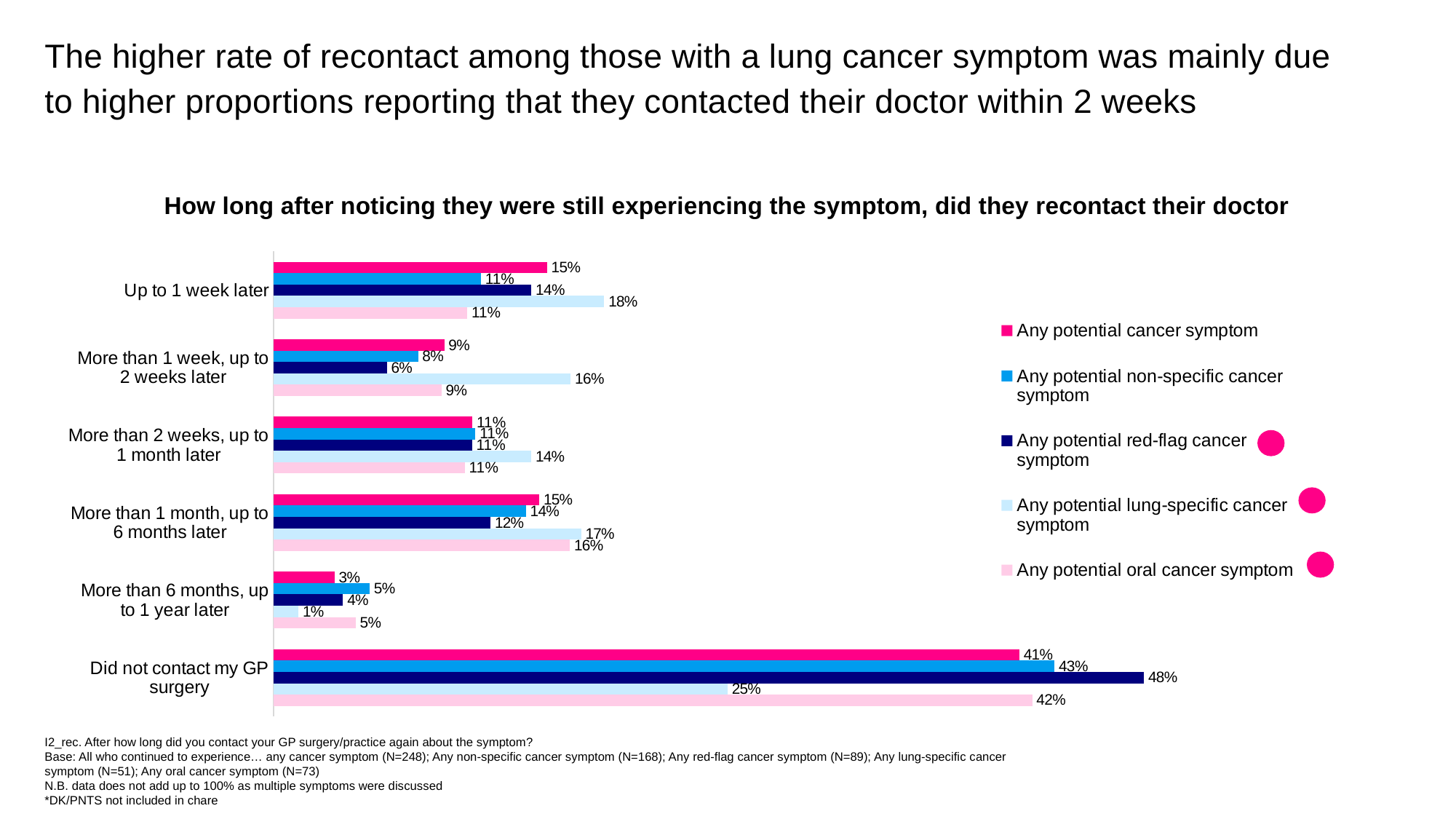
What is the title of the chart? How long after noticing they were still experiencing the symptom, did they recontact their doctor Which series has the lowest value in the 'Did not contact my GP surgery' category? Any potential lung-specific cancer symptom What kind of chart is shown on the slide? Bar chart What is the value for 'Any potential lung-specific cancer symptom' in the 'Up to 1 week later' category? 18% In the 'More than 1 month, up to 6 months later' category, which is larger: the value for 'Any potential oral cancer symptom' or 'Any potential red-flag cancer symptom'? Any potential oral cancer symptom What is the value for 'Any potential non-specific cancer symptom' in the 'More than 1 week, up to 2 weeks later' category? 8% What is the difference between the 'Any potential red-flag cancer symptom' and 'Any potential lung-specific cancer symptom' values in the 'Did not contact my GP surgery' category? 23% How many series does the legend list? 5 Which series has the highest value in the 'More than 1 week, up to 2 weeks later' category? Any potential lung-specific cancer symptom How many categories are shown on the chart? 6 What is the value for 'Any potential red-flag cancer symptom' in the 'Did not contact my GP surgery' category? 48% What is the value for 'Any potential cancer symptom' in the 'More than 6 months, up to 1 year later' category? 3%